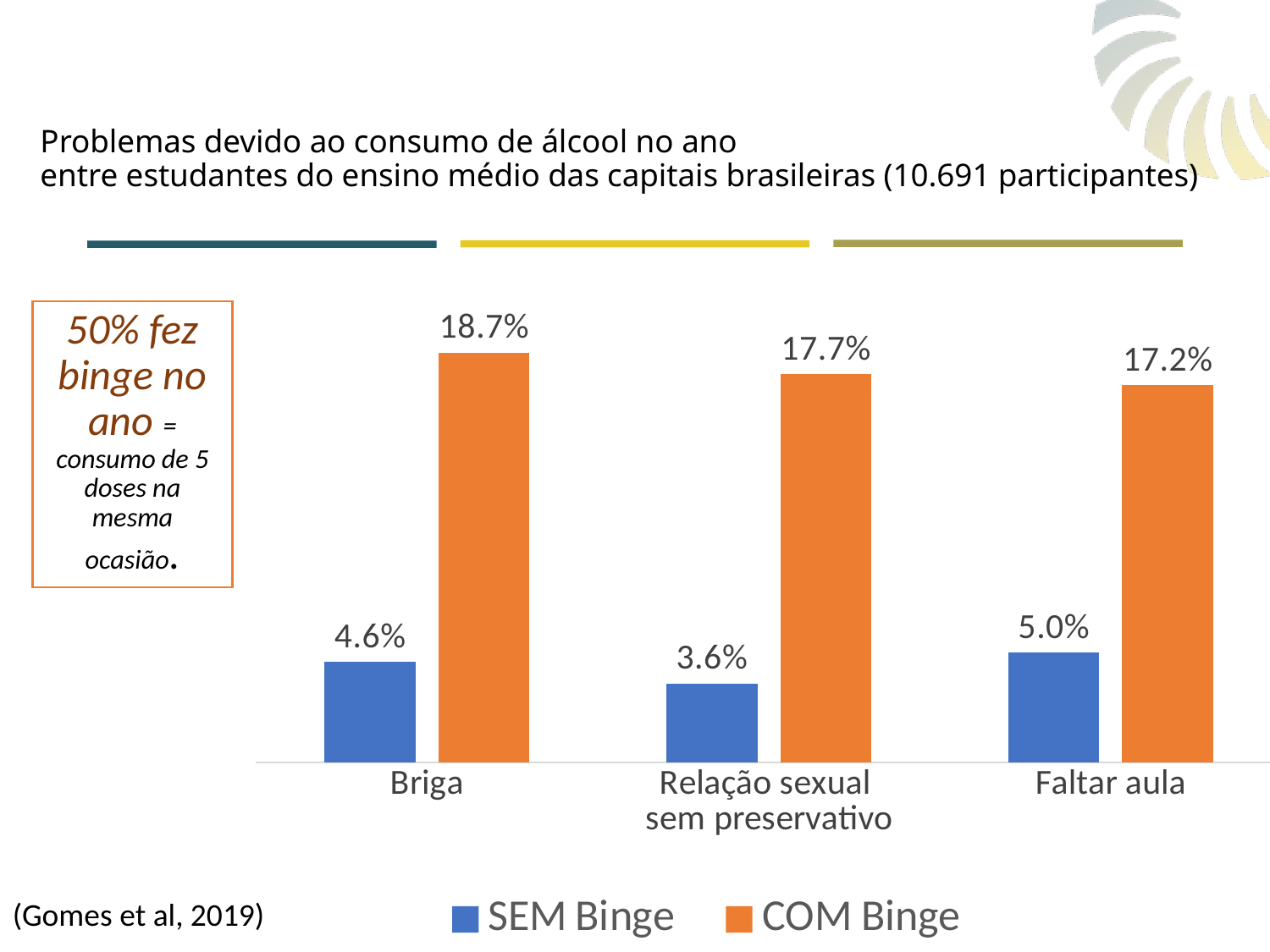
Which is larger for Relação sexual sem preservativo: the SEM Binge value or the COM Binge value? COM Binge What is the COM Binge value for Faltar aula? 17.2% What is the difference between the COM Binge and SEM Binge values for Briga? 14.1% How many series does the legend list? 2 Which category has the highest COM Binge value? Briga How many categories are shown on the x axis? 3 Which category has the lowest SEM Binge value? Relação sexual sem preservativo What is the SEM Binge value for Relação sexual sem preservativo? 3.6% What is the COM Binge value for Briga? 18.7% What kind of chart is shown on the slide? Bar chart What is the difference between the COM Binge values for Briga and Faltar aula? 1.5% What is the SEM Binge value for Faltar aula? 5.0%